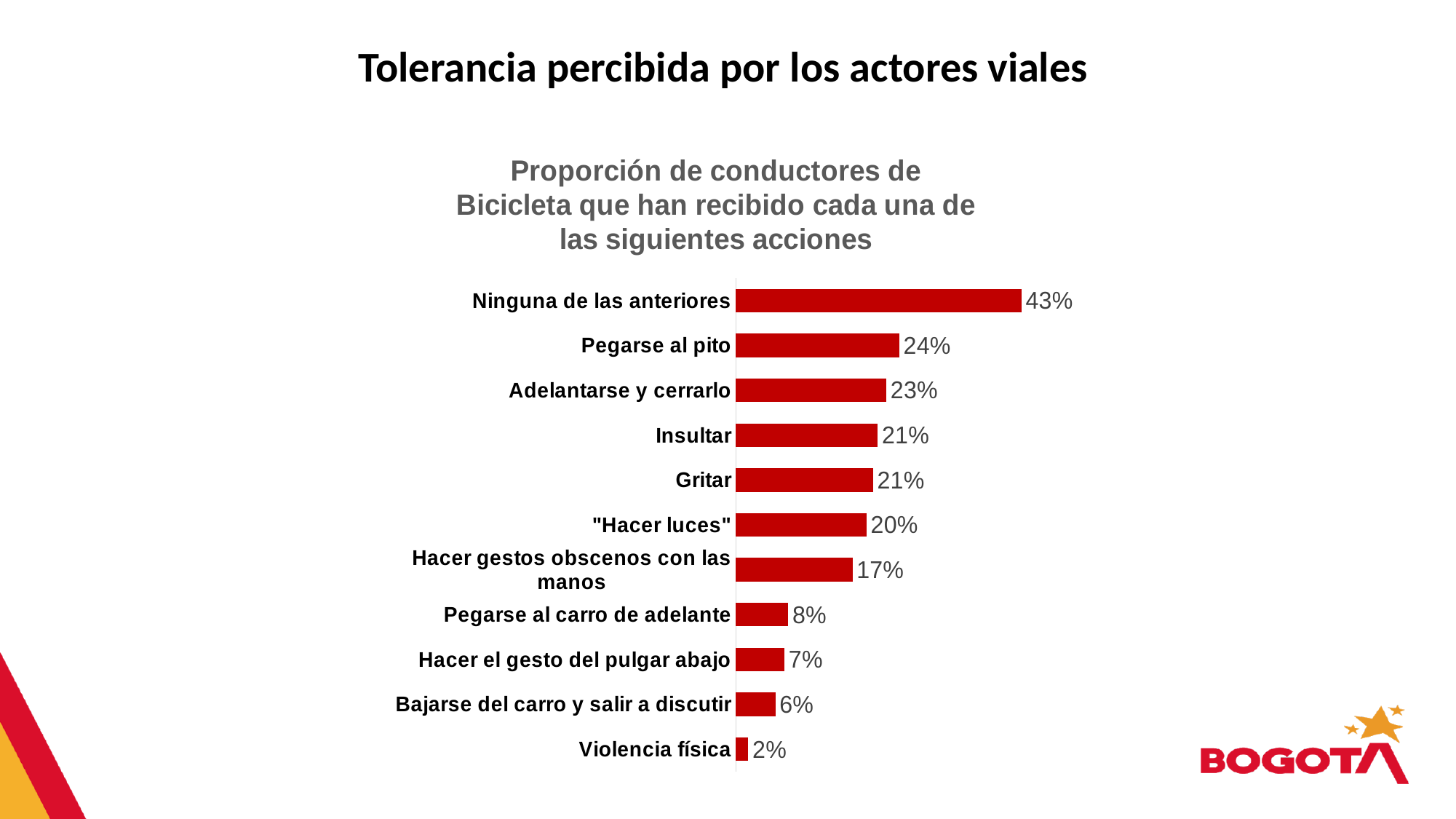
What is the value for "Violencia física"? 2% Which category has the highest value? Ninguna de las anteriores What kind of chart is shown on the slide? Bar chart Which category has the lowest value? Violencia física What is the title of the chart? Proporción de conductores de Bicicleta que han recibido cada una de las siguientes acciones What is the value for "Pegarse al pito"? 24% What is the value for "Hacer gestos obscenos con las manos"? 17% What is the difference between "Ninguna de las anteriores" and "Pegarse al pito"? 19% Which is larger, the value for "Adelantarse y cerrarlo" or the value for "Hacer luces"? Adelantarse y cerrarlo How many categories are shown in the chart? 11 What is the difference between "Pegarse al carro de adelante" and "Bajarse del carro y salir a discutir"? 2% What colour are the bars in the chart? Red